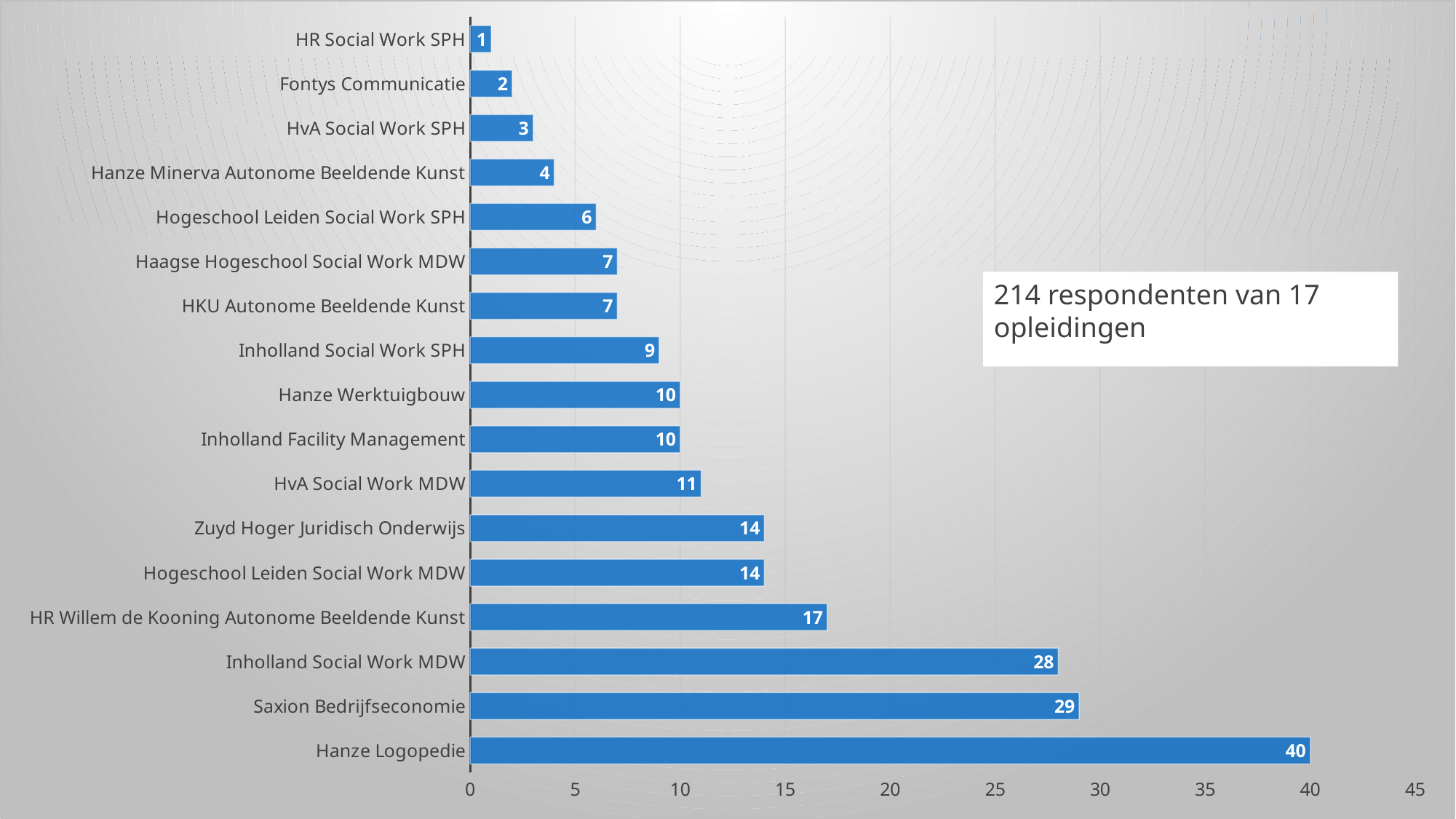
What is the difference between the values for Hanze Logopedie and HR Willem de Kooning Autonome Beeldende Kunst? 23 What is the value for Hanze Logopedie? 40 What does the text box on the slide say? 214 respondenten van 17 opleidingen What is the difference between the values for Saxion Bedrijfseconomie and Inholland Social Work MDW? 1 Which is larger, the value for Zuyd Hoger Juridisch Onderwijs or the value for HvA Social Work MDW? Zuyd Hoger Juridisch Onderwijs Which category has the lowest value? HR Social Work SPH What is the value for HKU Autonome Beeldende Kunst? 7 Is the value for Inholland Social Work SPH greater or less than 10? less Which category has the highest value? Hanze Logopedie How many categories are shown in the chart? 17 What kind of chart is shown on the slide? bar chart What is the value for Inholland Social Work MDW? 28